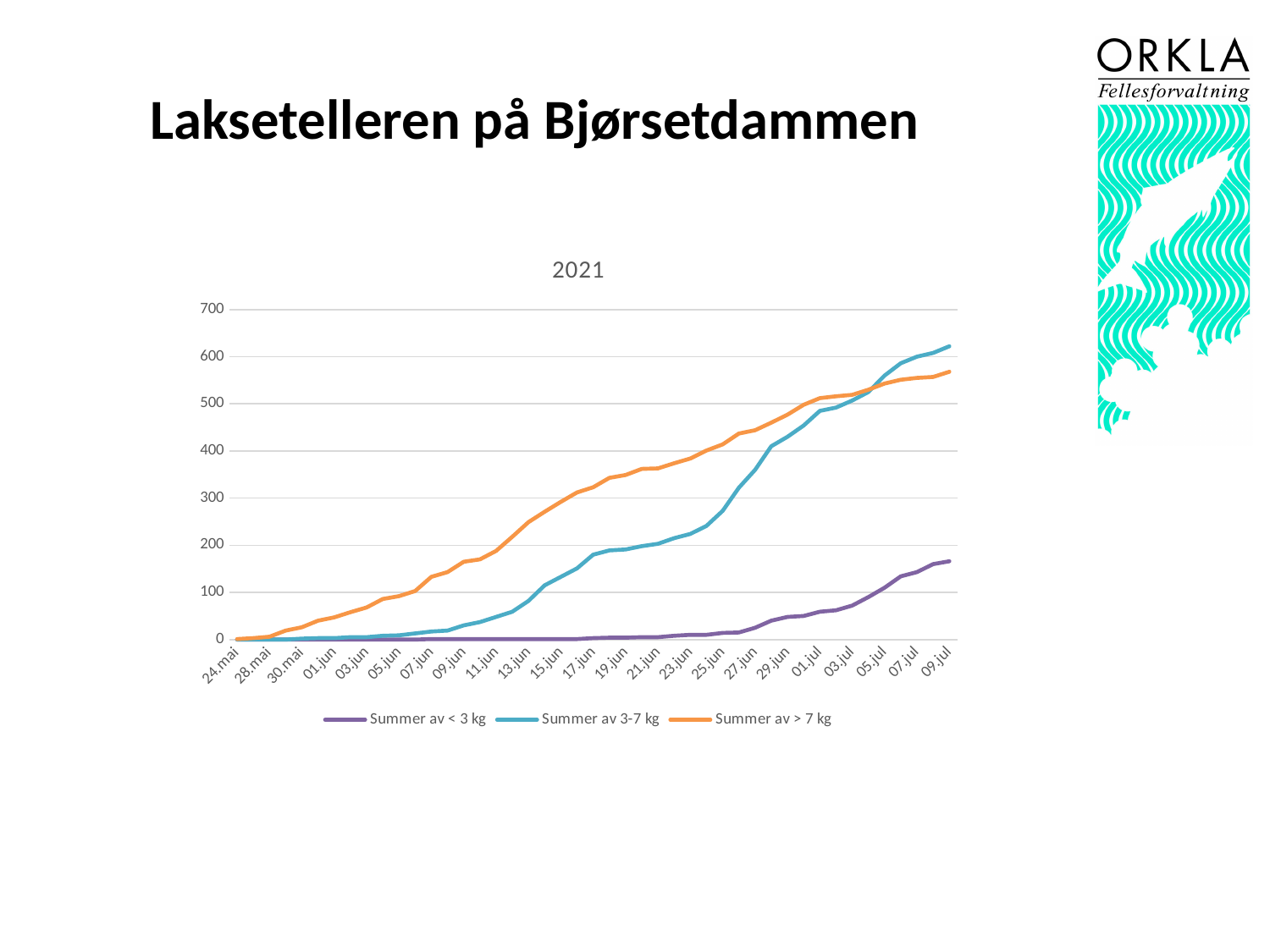
Is the value for Summer av > 7 kg at 09.jul greater or less than 600? less What kind of chart is shown on the slide? line chart At 09.jul, which series has the higher value: Summer av 3-7 kg or Summer av > 7 kg? Summer av 3-7 kg Do the values of the Summer av 3-7 kg series rise or fall along the x axis? rise How many series does the legend of the chart list? 3 At 15.jun, which series has the higher value: Summer av 3-7 kg or Summer av > 7 kg? Summer av > 7 kg What is the title of the chart? 2021 What colour is the line for Summer av > 7 kg? orange Which series has the lowest value at 09.jul? Summer av < 3 kg Is the value for Summer av > 7 kg at 21.jun greater or less than 300? greater Is the value for Summer av < 3 kg at 09.jul greater or less than 200? less